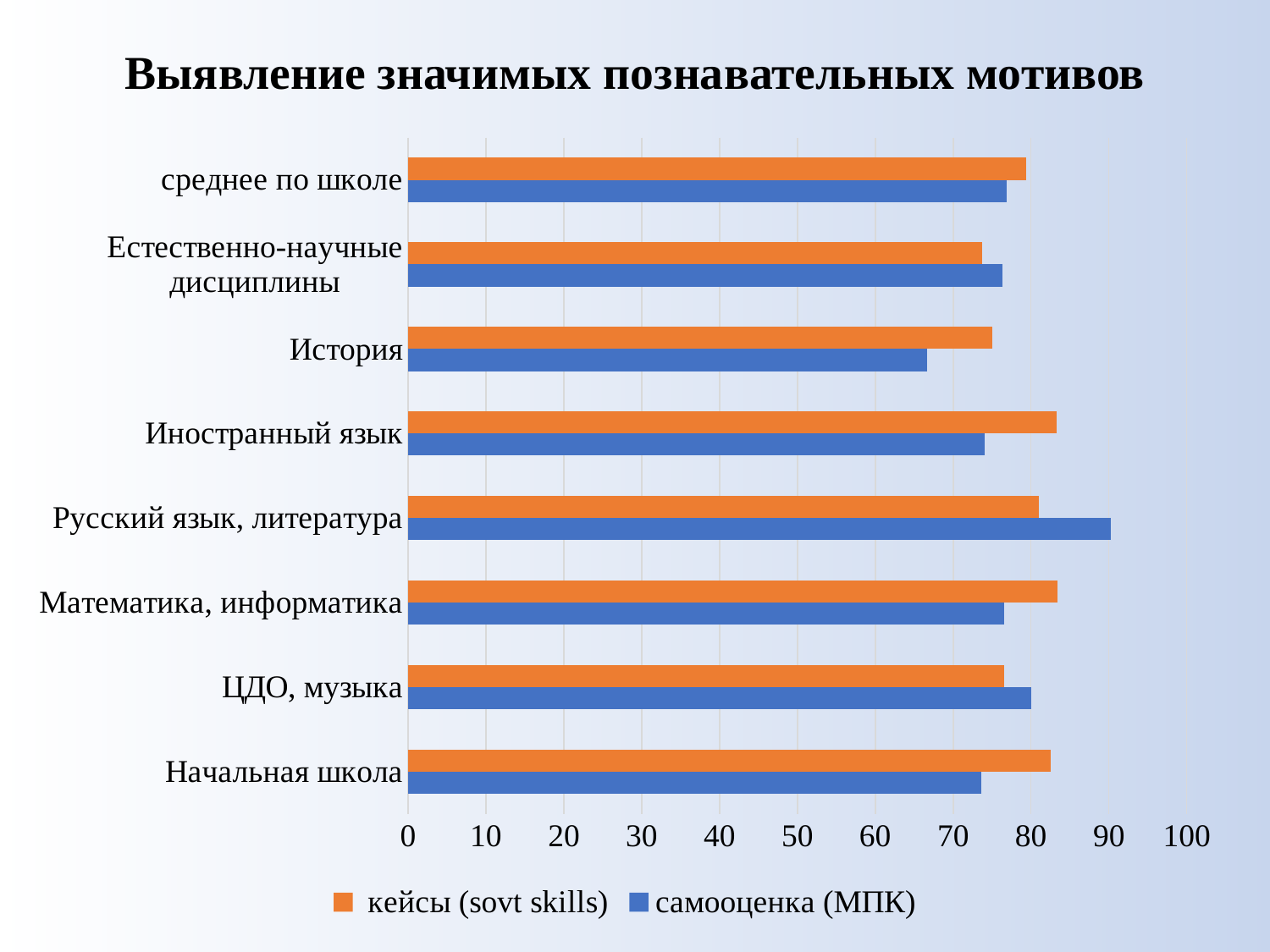
What is the title of the chart? Выявление значимых познавательных мотивов What kind of chart is shown on the slide? bar chart Is the самооценка (МПК) value for Русский язык, литература greater or less than 80? greater For Начальная школа, which series has the larger value: кейсы (sovt skills) or самооценка (МПК)? кейсы (sovt skills) Is the кейсы (sovt skills) value for Иностранный язык greater or less than 80? greater For Русский язык, литература, which series has the larger value: кейсы (sovt skills) or самооценка (МПК)? самооценка (МПК) Is the самооценка (МПК) value for История greater or less than 70? less Which category has the highest value for самооценка (МПК)? Русский язык, литература Which category has the lowest value for самооценка (МПК)? История For История, which series has the larger value: кейсы (sovt skills) or самооценка (МПК)? кейсы (sovt skills) How many series does the legend list? 2 How many categories are shown on the vertical axis of the chart? 8